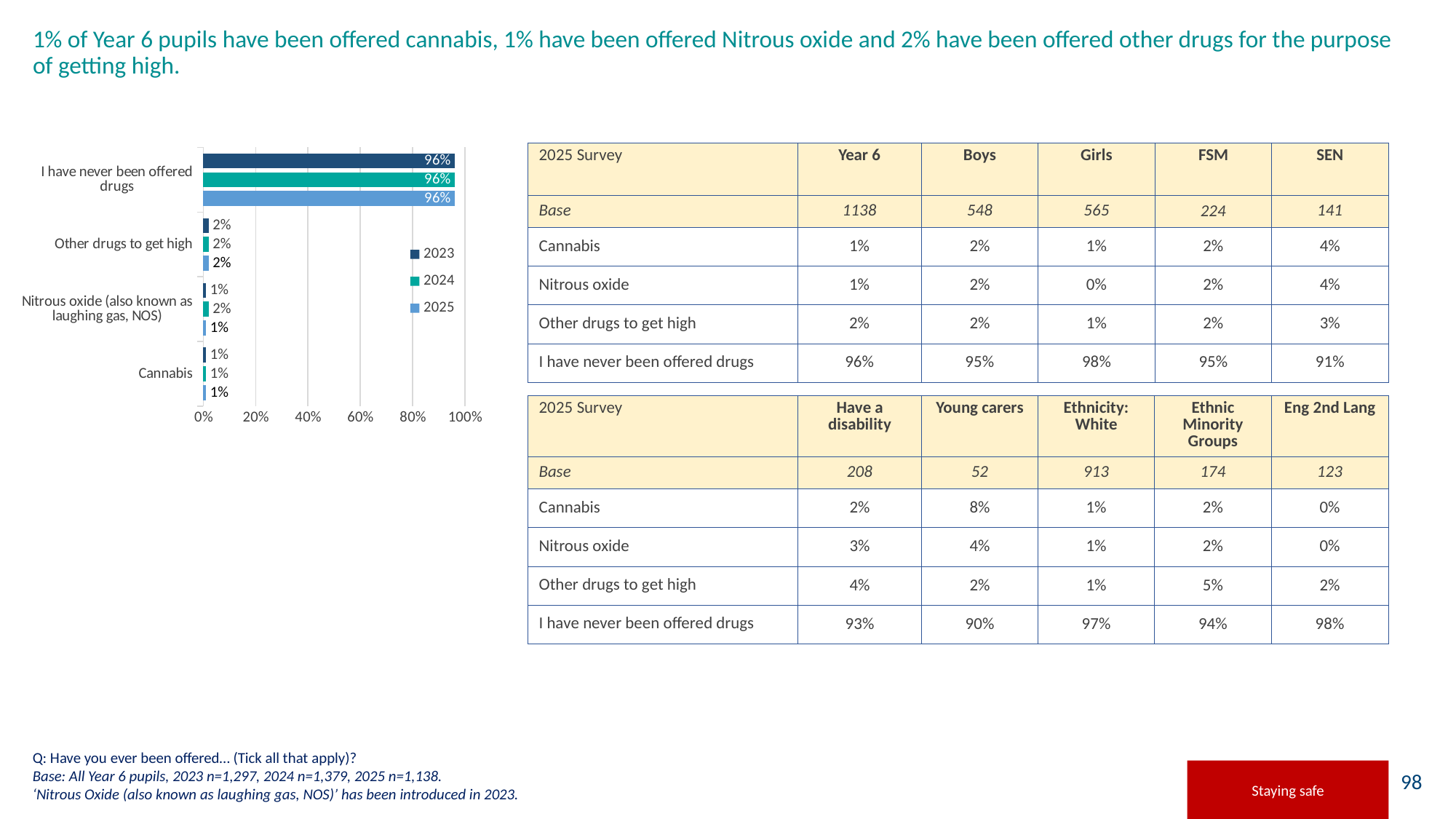
Which years are listed in the chart legend? 2023, 2024, 2025 What type of chart is shown on the slide? Bar chart What is the 2025 value for 'Other drugs to get high' in the chart? 2% What is the 2023 value for 'Cannabis' in the chart? 1% Which category has the highest values in the chart? I have never been offered drugs What is the 2025 value for 'I have never been offered drugs' in the chart? 96% In the chart, is the 2025 value for 'Other drugs to get high' larger or smaller than the 2025 value for 'Cannabis'? Larger How many categories are shown on the chart? 4 How many series does the chart legend list? 3 What is the 2024 value for 'Nitrous oxide (also known as laughing gas, NOS)' in the chart? 2% What is the difference between the 2024 and 2025 values for 'Nitrous oxide (also known as laughing gas, NOS)' in the chart? 1% Is the 2023 value for 'I have never been offered drugs' greater or less than 80%? greater